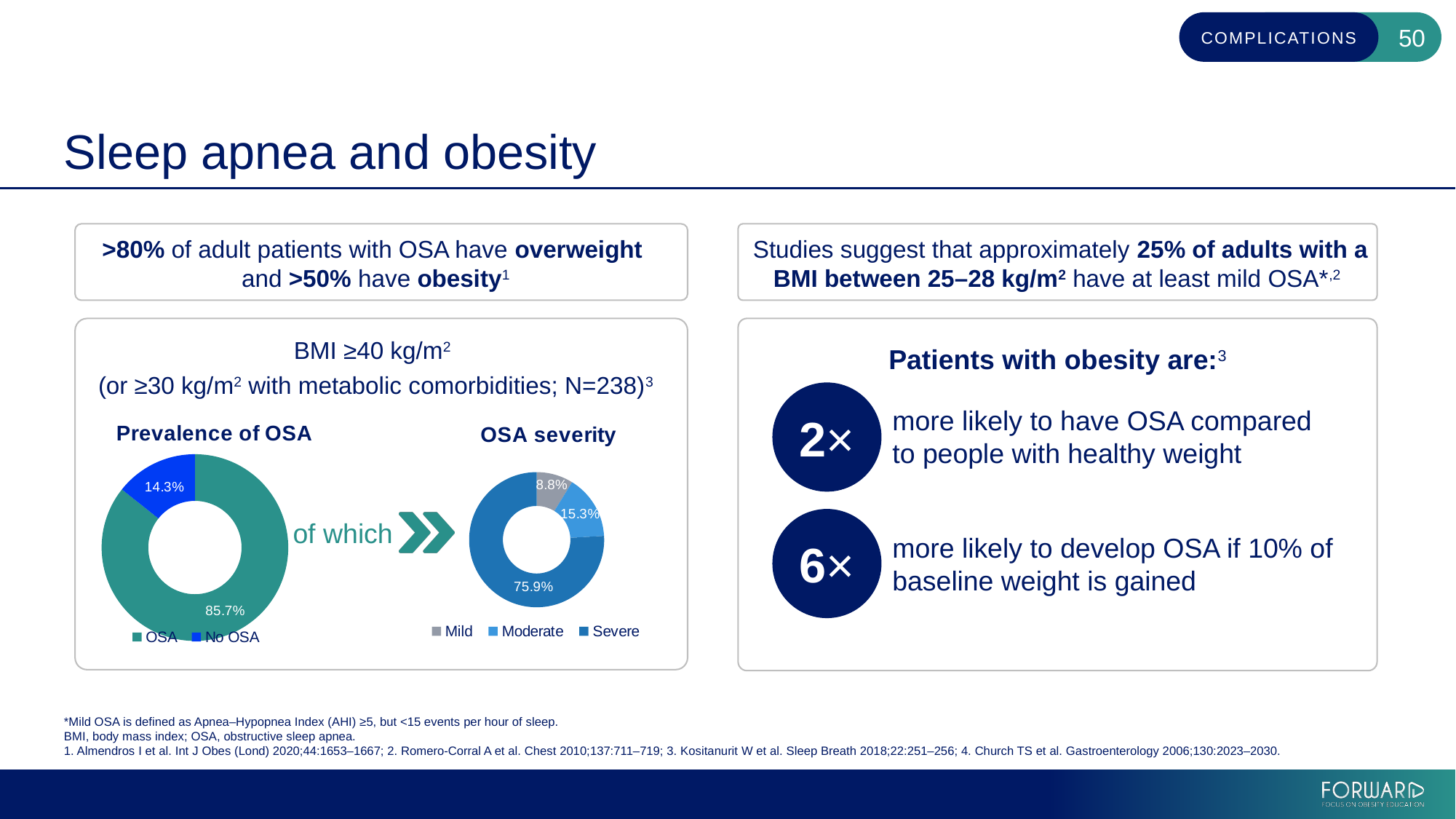
What type of chart is the 'Prevalence of OSA' chart? Donut (pie) chart In the 'OSA severity' chart, what share of patients have mild OSA? 8.8% In the 'Prevalence of OSA' chart, what is the difference between the OSA and No OSA shares? 71.4% How many categories does the 'OSA severity' chart show? 3 In the 'OSA severity' chart, what share of patients have moderate OSA? 15.3% In the 'OSA severity' chart, is the moderate share larger or smaller than the mild share? Larger In the 'OSA severity' chart, which severity category is the smallest? Mild In the 'Prevalence of OSA' chart, what percentage of patients have OSA? 85.7% What are the legend entries of the 'Prevalence of OSA' chart? OSA, No OSA In the 'OSA severity' chart, which severity category is the largest? Severe In the 'OSA severity' chart, what share of patients have severe OSA? 75.9% In the 'Prevalence of OSA' chart, what percentage of patients have no OSA? 14.3%